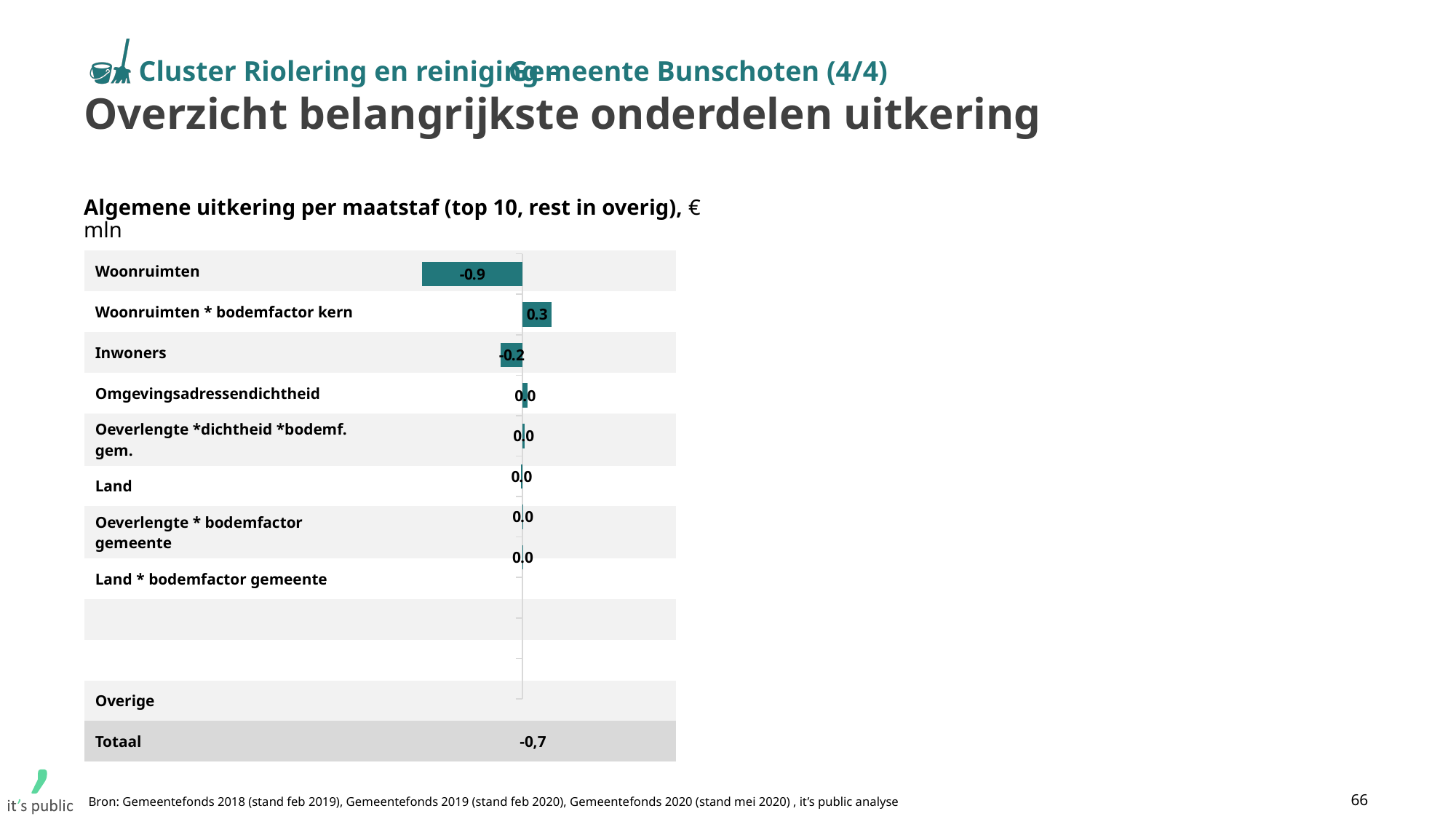
How many categories have a data label of 0.0? 5 Which category has the lowest value? Woonruimten What is the difference between the values for Woonruimten * bodemfactor kern and Inwoners? 0.5 What is the title of the chart? Algemene uitkering per maatstaf (top 10, rest in overig), € mln What is the value for Woonruimten * bodemfactor kern? 0.3 What is the value shown for Totaal? -0,7 Which has the larger value, Woonruimten or Inwoners? Inwoners What kind of chart is shown on the slide? Bar chart Which category has the highest value? Woonruimten * bodemfactor kern What is the value for Woonruimten? -0.9 What is the value for Inwoners? -0.2 What is the difference between the values for Woonruimten * bodemfactor kern and Woonruimten? 1.2